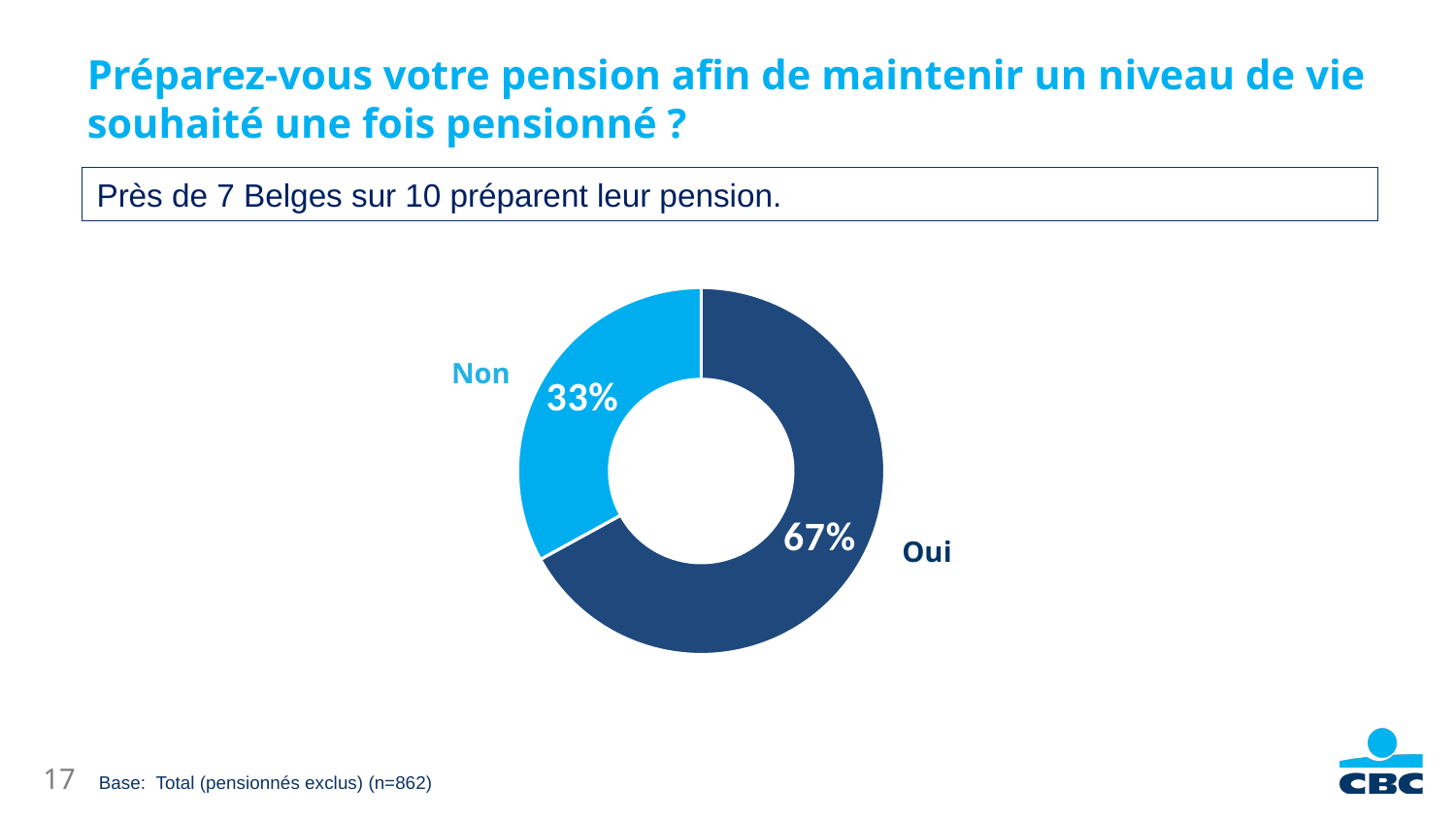
Which category has the smallest share of the chart? Non What kind of chart is shown on the slide? Doughnut chart How many categories are shown in the chart? 2 What is the difference in percentage points between "Oui" and "Non"? 34 What colour is the "Oui" segment of the chart? Dark blue What percentage of respondents answered "Oui"? 67% What is the sample size (n) stated in the base note below the chart? 862 What percentage of respondents answered "Non"? 33% What share of the chart does the "Non" slice represent? 33% Which is larger, the share for "Oui" or the share for "Non"? Oui Which category has the largest share of the chart? Oui